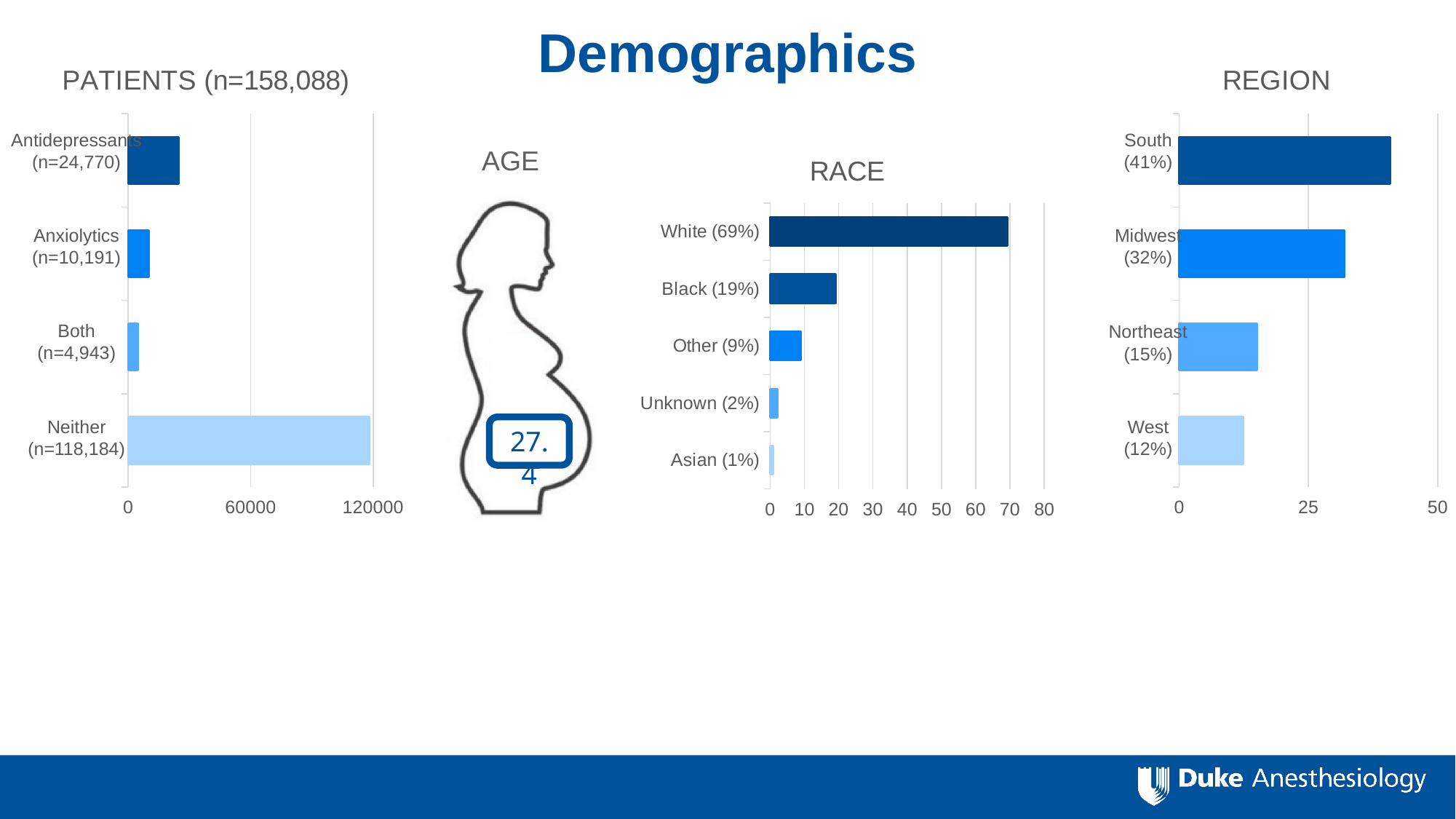
In the PATIENTS chart, what is the difference between the Antidepressants count and the Anxiolytics count? 14,579 In the PATIENTS chart, which category has the lowest count? Both What kind of chart is the RACE chart? bar chart In the PATIENTS chart, how many categories are shown? 4 In the RACE chart, what percentage is shown for Black? 19% In the REGION chart, is the value for South greater or less than 25? greater In the REGION chart, what percentage is shown for the Midwest? 32% In the PATIENTS chart, how many patients are in the Neither group? 118,184 In the RACE chart, how many categories are shown? 5 In the RACE chart, which category has the highest value? White In the REGION chart, what is the difference between the South and Northeast percentages? 26% In the REGION chart, which region has the lowest share? West